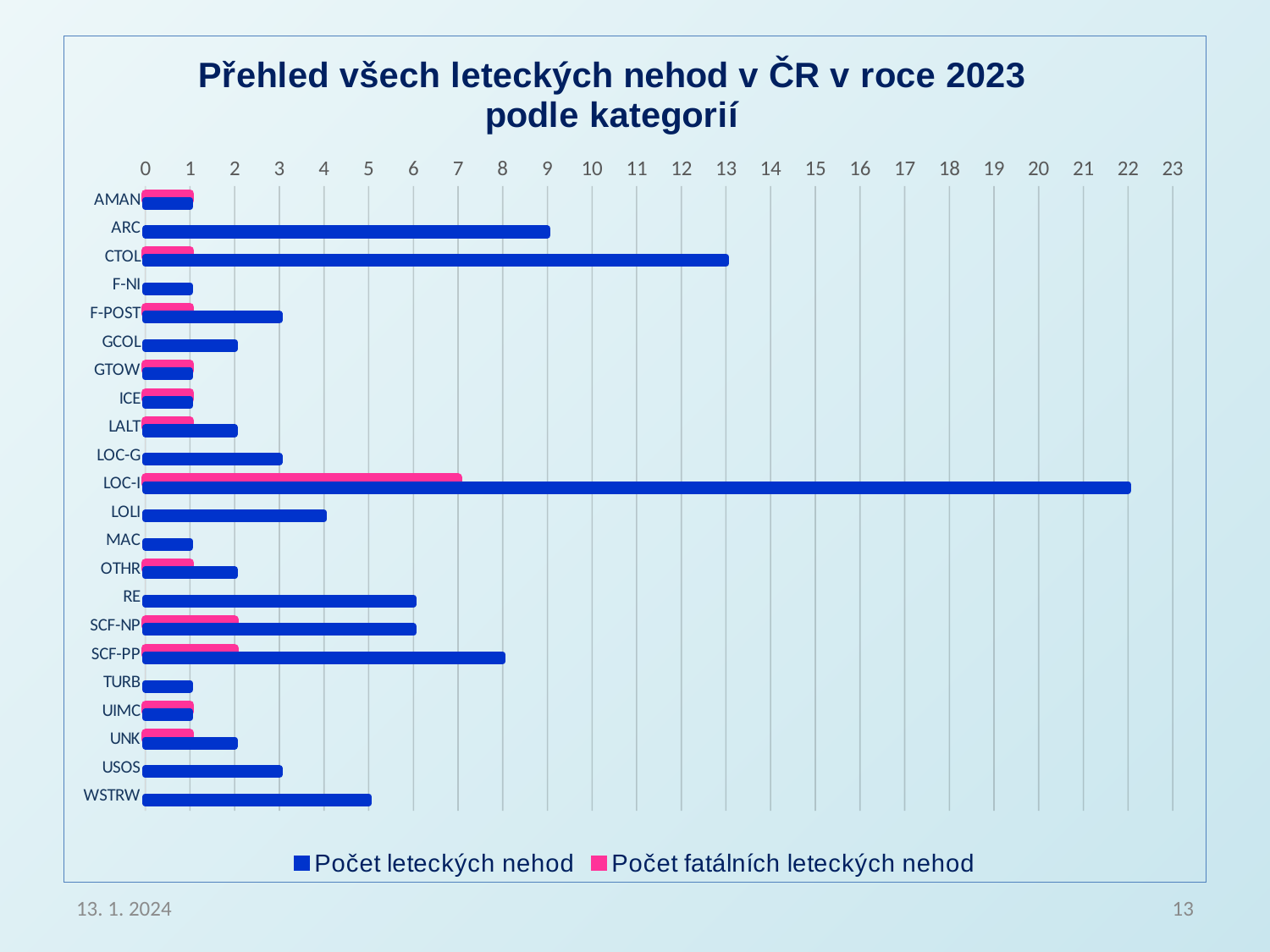
Is the value of Počet leteckých nehod for LOC-I greater or less than 20? greater What is the value of Počet leteckých nehod for ARC? 9 How many categories are shown on the vertical axis? 22 What type of chart is shown on the slide? bar chart Which category has the highest value for Počet leteckých nehod? LOC-I How many series does the legend list? 2 Which is larger, Počet leteckých nehod for SCF-PP or for RE? SCF-PP What is the title of the chart? Přehled všech leteckých nehod v ČR v roce 2023 podle kategorií What is the value of Počet fatálních leteckých nehod for LOC-I? 7 What is the value of Počet leteckých nehod for LOC-I? 22 What is the value of Počet leteckých nehod for CTOL? 13 What is the difference between Počet leteckých nehod for LOC-I and for CTOL? 9